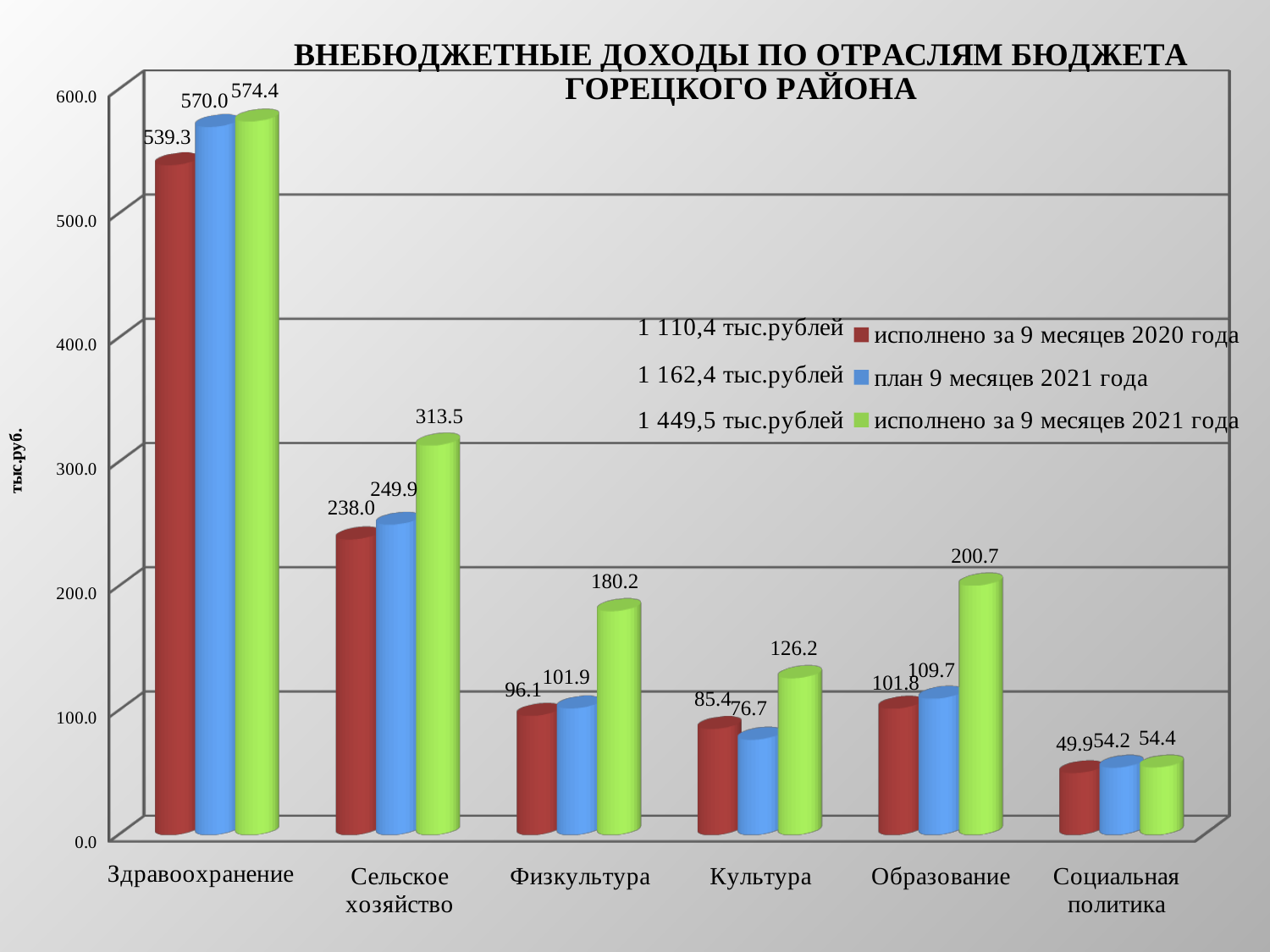
What is the value for Культура in the series 'план 9 месяцев 2021 года'? 76.7 Which category has the highest value in the series 'исполнено за 9 месяцев 2020 года'? Здравоохранение For Сельское хозяйство, what is the difference between 'исполнено за 9 месяцев 2021 года' and 'план 9 месяцев 2021 года'? 63.6 How many categories are shown on the x axis? 6 What unit is shown on the vertical axis label? тыс.руб. How many series does the legend list? 3 What kind of chart is shown on the slide? bar chart For Культура, which is larger: 'исполнено за 9 месяцев 2020 года' or 'план 9 месяцев 2021 года'? исполнено за 9 месяцев 2020 года For Образование, what is the difference between 'исполнено за 9 месяцев 2021 года' and 'исполнено за 9 месяцев 2020 года'? 98.9 What is the value for Физкультура in the series 'исполнено за 9 месяцев 2021 года'? 180.2 Which category has the lowest value in the series 'план 9 месяцев 2021 года'? Социальная политика What is the value for Здравоохранение in the series 'план 9 месяцев 2021 года'? 570.0